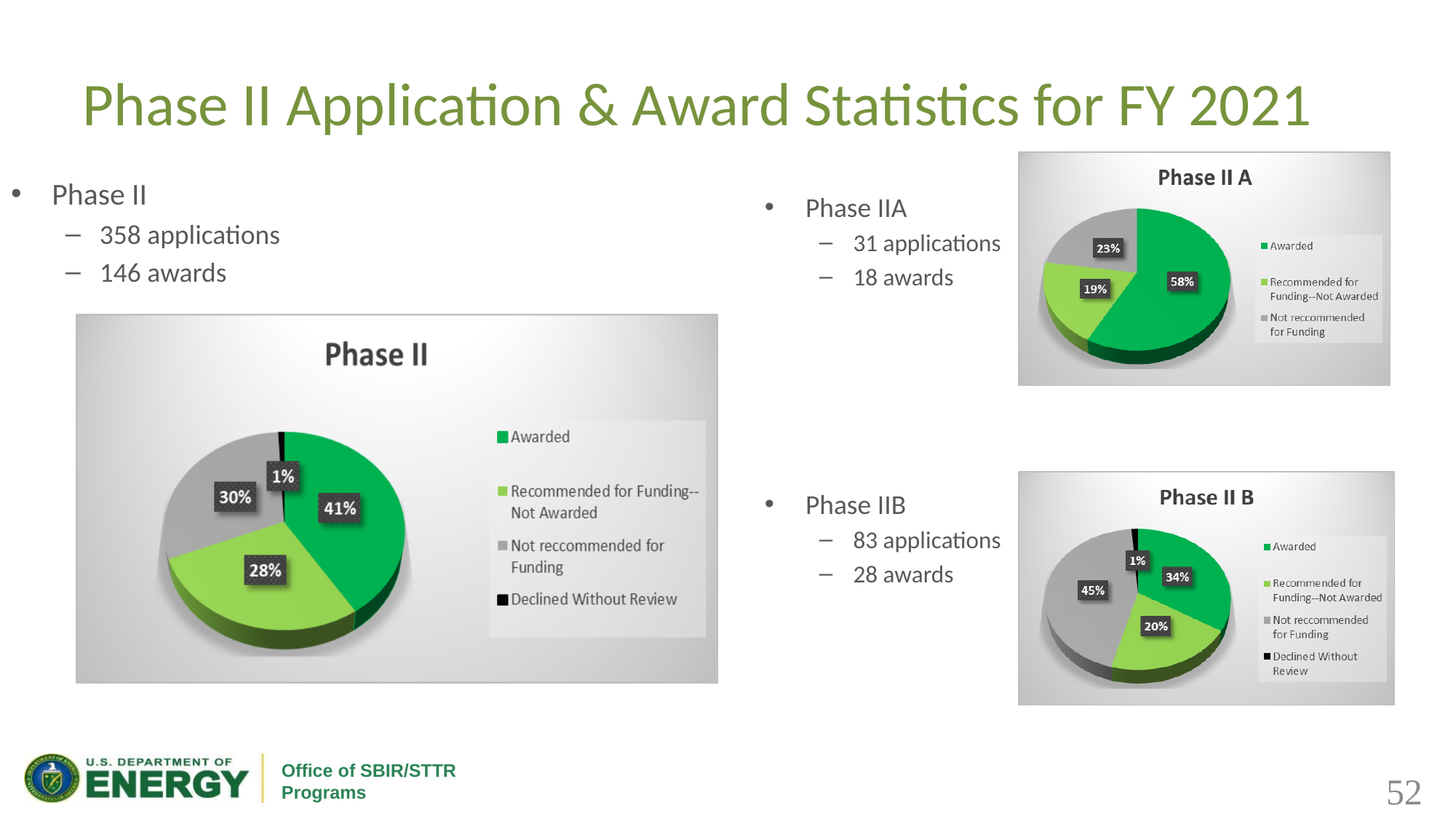
In the Phase II A chart, what share of the pie is Awarded? 58% In the Phase II chart, what share of the pie is Awarded? 41% In the Phase II chart, which category has the smallest slice? Declined Without Review How many slices does the Phase II A pie chart have? 3 What type of chart is the Phase II B chart? Pie chart In the Phase II B chart, what percentage is labelled for Not recommended for Funding? 45% In the Phase II B chart, what is the difference between the Not recommended for Funding share and the Awarded share? 11% In the Phase II chart, what is the difference between the Awarded share and the Recommended for Funding--Not Awarded share? 13% In the Phase II chart, what percentage is labelled for Not reccommended for Funding? 30% How many categories does the legend of the Phase II chart list? 4 In the Phase II A chart, which category has the largest slice? Awarded In the Phase II A chart, which is larger: Recommended for Funding--Not Awarded or Not reccommended for Funding? Not reccommended for Funding